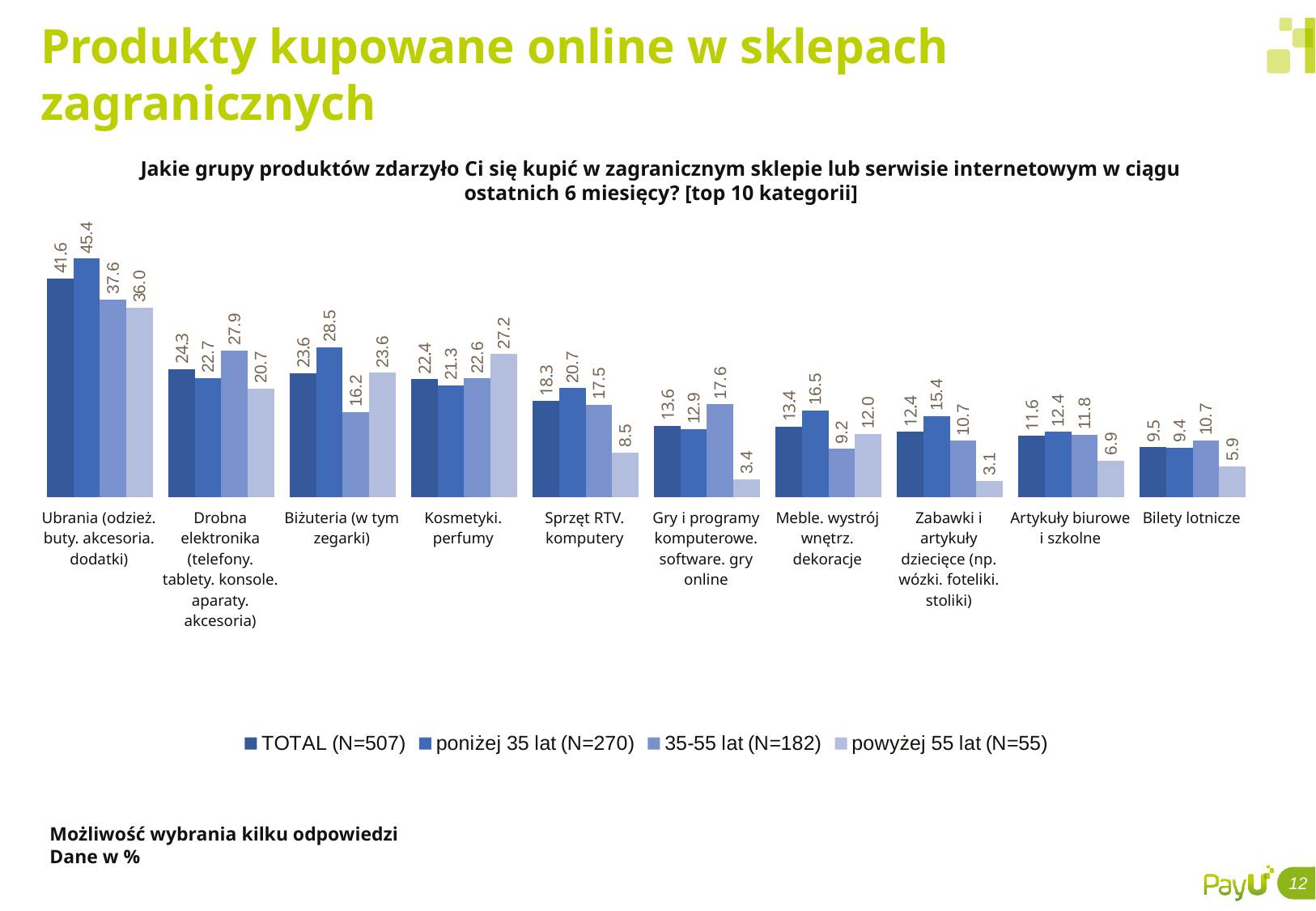
What is the difference between the poniżej 35 lat and powyżej 55 lat values for Sprzęt RTV, komputery? 12.2 How many series does the legend list? 4 Which category has the highest TOTAL value? Ubrania (odzież, buty, akcesoria, dodatki) What is the value for poniżej 35 lat for Biżuteria (w tym zegarki)? 28.5 Which category has the lowest TOTAL value? Bilety lotnicze What is the value for powyżej 55 lat for Gry i programy komputerowe, software, gry online? 3.4 What is the value for 35-55 lat for Kosmetyki, perfumy? 22.6 What is the TOTAL value for Ubrania (odzież, buty, akcesoria, dodatki)? 41.6 What is the sample size (N) for the 35-55 lat series in the legend? 182 What kind of chart is shown on the slide? Bar chart For Drobna elektronika, which is larger: the 35-55 lat value or the poniżej 35 lat value? 35-55 lat How many product categories are shown on the chart? 10